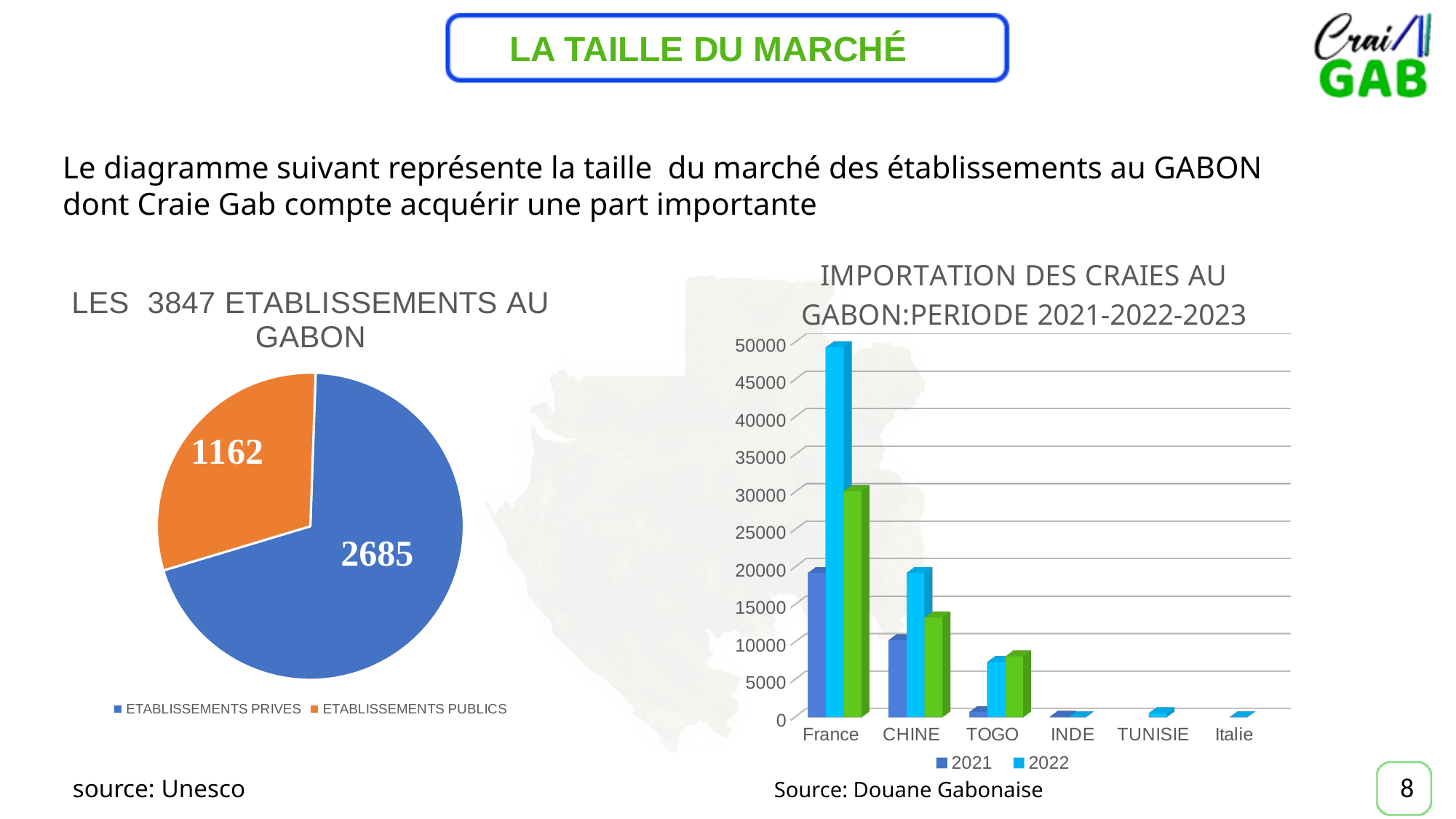
On the chart 'IMPORTATION DES CRAIES AU GABON:PERIODE 2021-2022-2023', how many series does the legend list? 2 On the chart 'IMPORTATION DES CRAIES AU GABON:PERIODE 2021-2022-2023', is the 2022 value for France greater or less than 45000? greater What kind of chart is 'IMPORTATION DES CRAIES AU GABON:PERIODE 2021-2022-2023'? Bar chart On the pie chart 'LES 3847 ETABLISSEMENTS AU GABON', what is the value for ETABLISSEMENTS PUBLICS? 1162 On the pie chart 'LES 3847 ETABLISSEMENTS AU GABON', which category is the largest? ETABLISSEMENTS PRIVES What kind of chart is the one on the left of the slide? Pie chart On the pie chart 'LES 3847 ETABLISSEMENTS AU GABON', what is the value for ETABLISSEMENTS PRIVES? 2685 On the chart 'IMPORTATION DES CRAIES AU GABON:PERIODE 2021-2022-2023', which country has the highest value for 2022? France On the chart 'IMPORTATION DES CRAIES AU GABON:PERIODE 2021-2022-2023', which is larger for 2022: France or CHINE? France On the pie chart 'LES 3847 ETABLISSEMENTS AU GABON', what is the difference between ETABLISSEMENTS PRIVES and ETABLISSEMENTS PUBLICS? 1523 On the chart 'IMPORTATION DES CRAIES AU GABON:PERIODE 2021-2022-2023', how many countries are shown on the x axis? 6